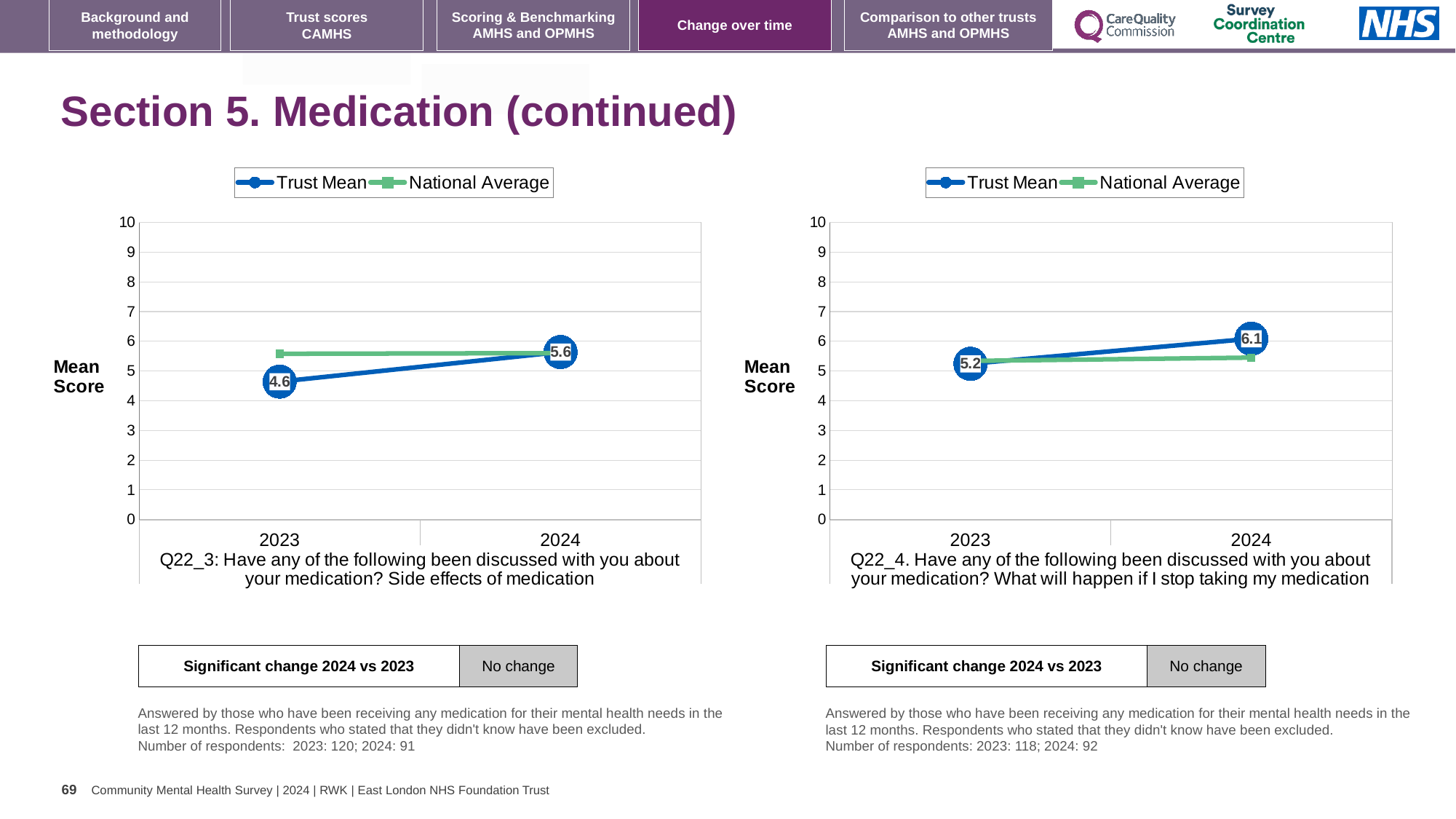
In the right chart (Q22_4), does the Trust Mean rise or fall from 2023 to 2024? rise How many years are shown on the x axis of the left chart (Q22_3)? 2 What kind of chart is the left chart (Q22_3)? line chart In the left chart (Q22_3), what is the Trust Mean for 2024? 5.6 In the right chart (Q22_4), what is the difference between the Trust Mean in 2024 and 2023? 0.9 How many series does the legend of the right chart (Q22_4) list? 2 In the left chart (Q22_3), what is the Trust Mean for 2023? 4.6 In the right chart (Q22_4), what is the Trust Mean for 2024? 6.1 In the right chart (Q22_4), what is the Trust Mean for 2023? 5.2 In the left chart (Q22_3), by how much did the Trust Mean change from 2023 to 2024? 1.0 In the left chart (Q22_3), is the National Average for 2023 greater or less than 5? greater In the right chart (Q22_4), which is larger in 2024, the Trust Mean or the National Average? Trust Mean